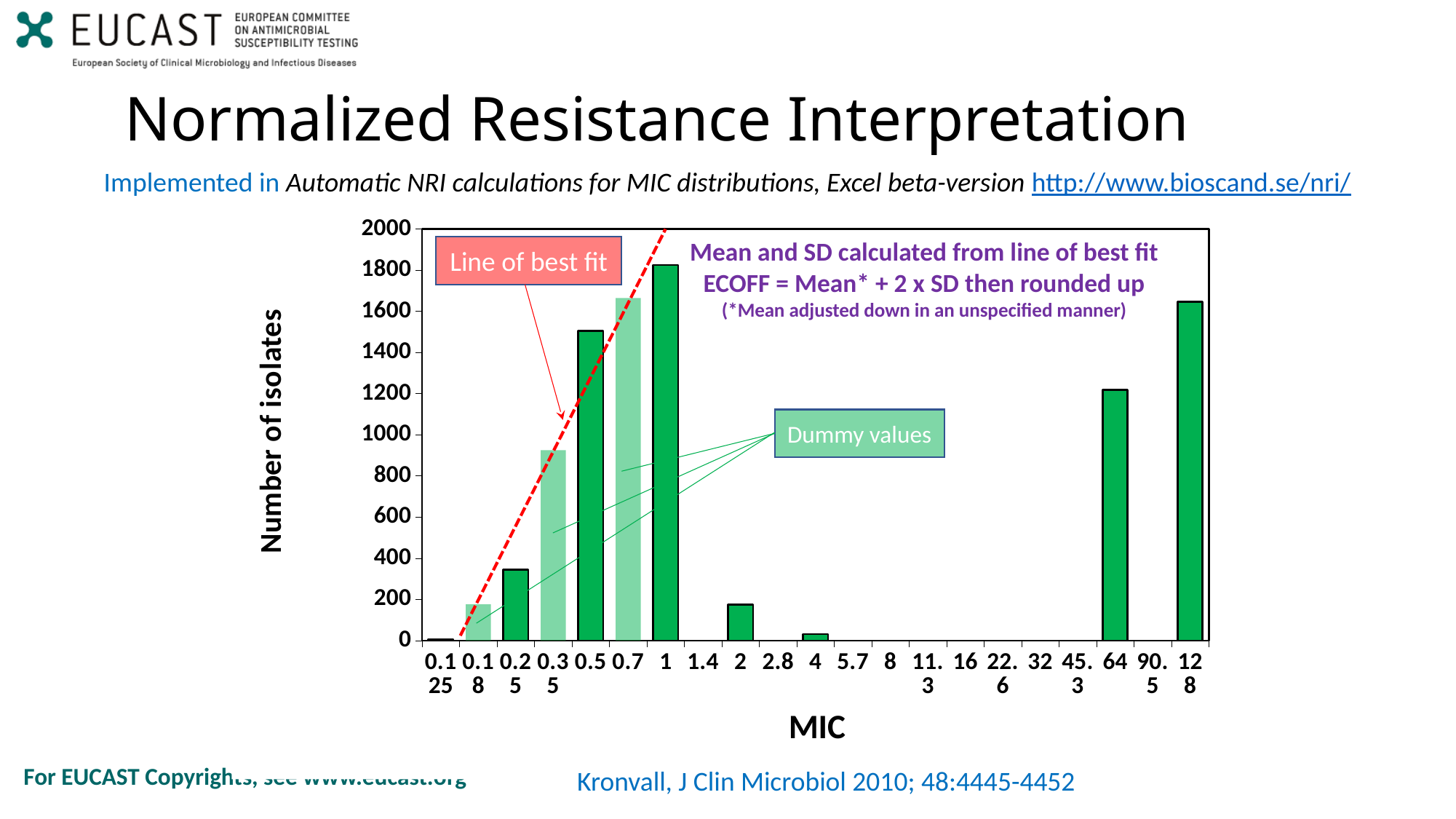
Which has more isolates, MIC 0.5 or MIC 0.7? 0.7 What does the dashed red line on the chart represent? Line of best fit Which MIC category has the highest number of isolates? 1 Is the number of isolates at MIC 0.35 greater or less than 800? greater What kind of chart is shown on the slide? bar chart Which has more isolates, MIC 64 or MIC 128? 128 Is the number of isolates at MIC 0.25 greater or less than 400? less Is the number of isolates at MIC 64 greater or less than 1000? greater How many MIC categories are shown on the x axis? 21 What is the title of the y axis of the chart? Number of isolates